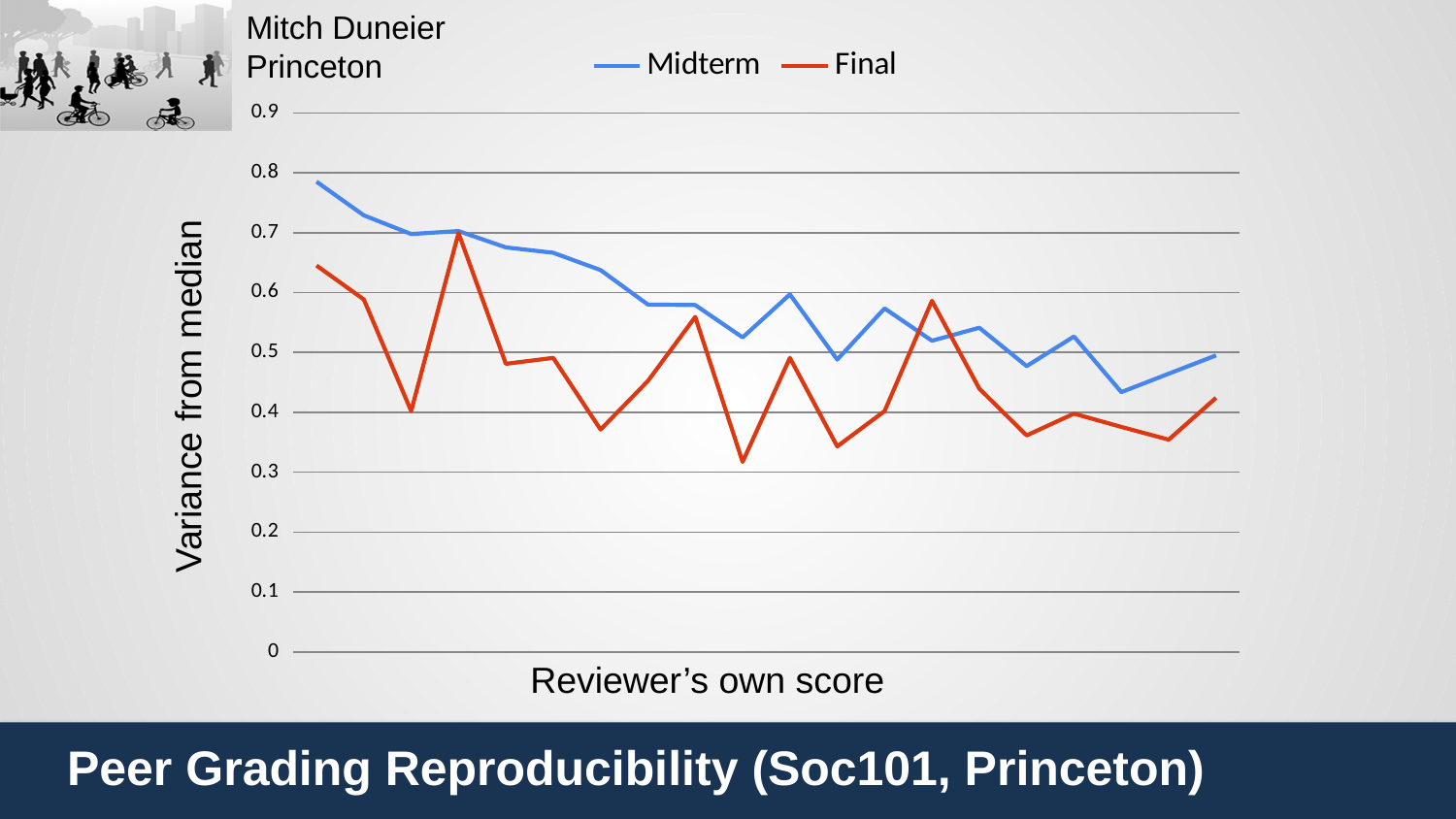
What is the label on the vertical axis? Variance from median What are the two series named in the legend? Midterm and Final How many series does the legend list? 2 Which series is drawn in red? Final Does the Midterm line generally rise or fall from left to right? Fall What kind of chart is shown on the slide? Line chart Is the leftmost value of the Final series greater or less than 0.6? greater Which series reaches the highest value on the chart? Midterm Is the leftmost value of the Midterm series greater or less than 0.7? greater Is the lowest value of the Final series greater or less than 0.4? less Which series has the higher value at the leftmost point, Midterm or Final? Midterm